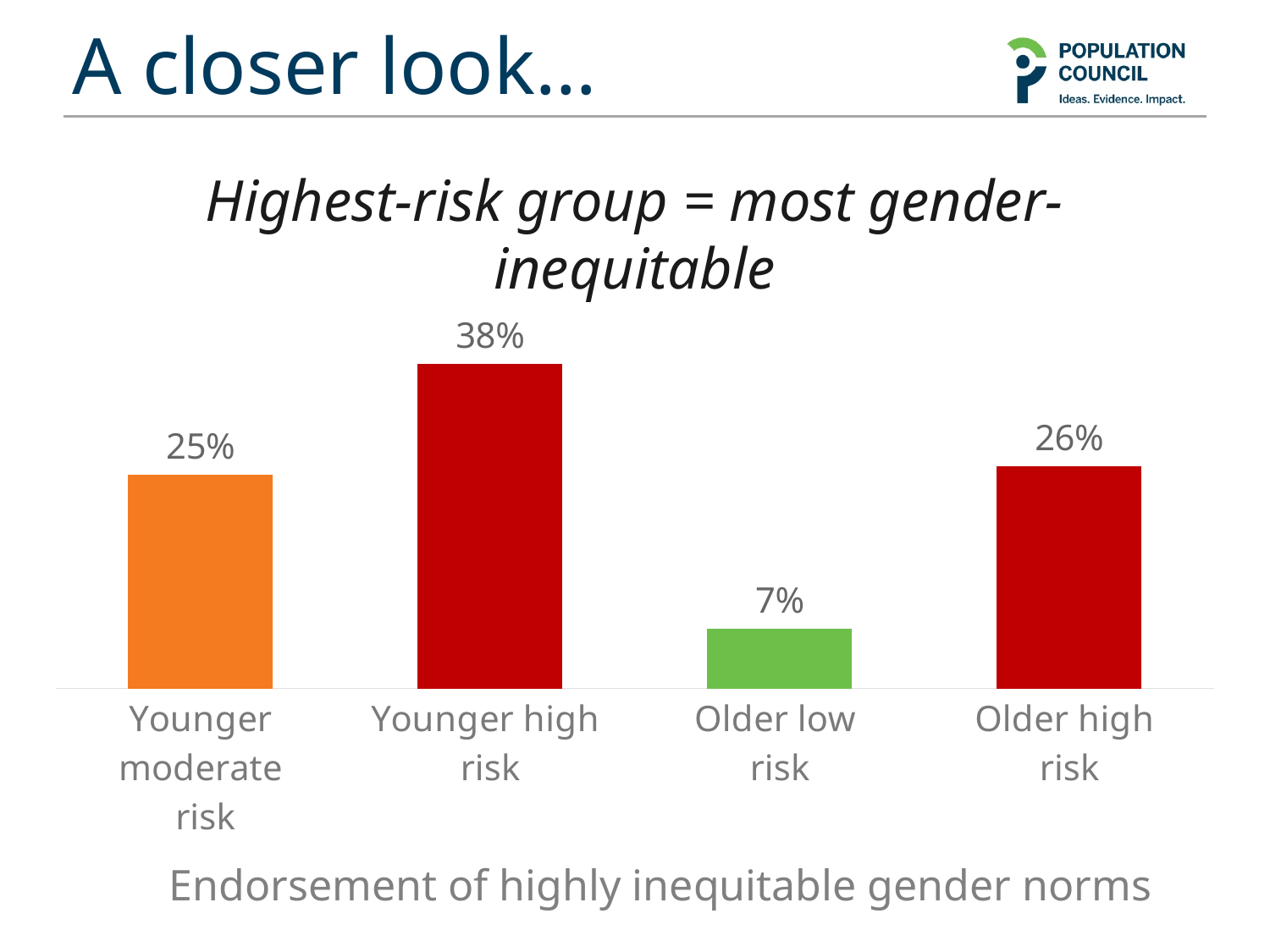
What is the difference between the values for Younger moderate risk and Older low risk? 18% What kind of chart is shown on the slide? Bar chart What is the value for Younger moderate risk? 25% How many categories are shown in the chart? 4 Which is larger, the value for Younger high risk or the value for Younger moderate risk? Younger high risk Which category has the highest value? Younger high risk Which category has the lowest value? Older low risk What is the value for Younger high risk? 38% What is the caption below the chart? Endorsement of highly inequitable gender norms What is the value for Older high risk? 26% What is the difference between the values for Younger high risk and Older high risk? 12% What is the value for Older low risk? 7%